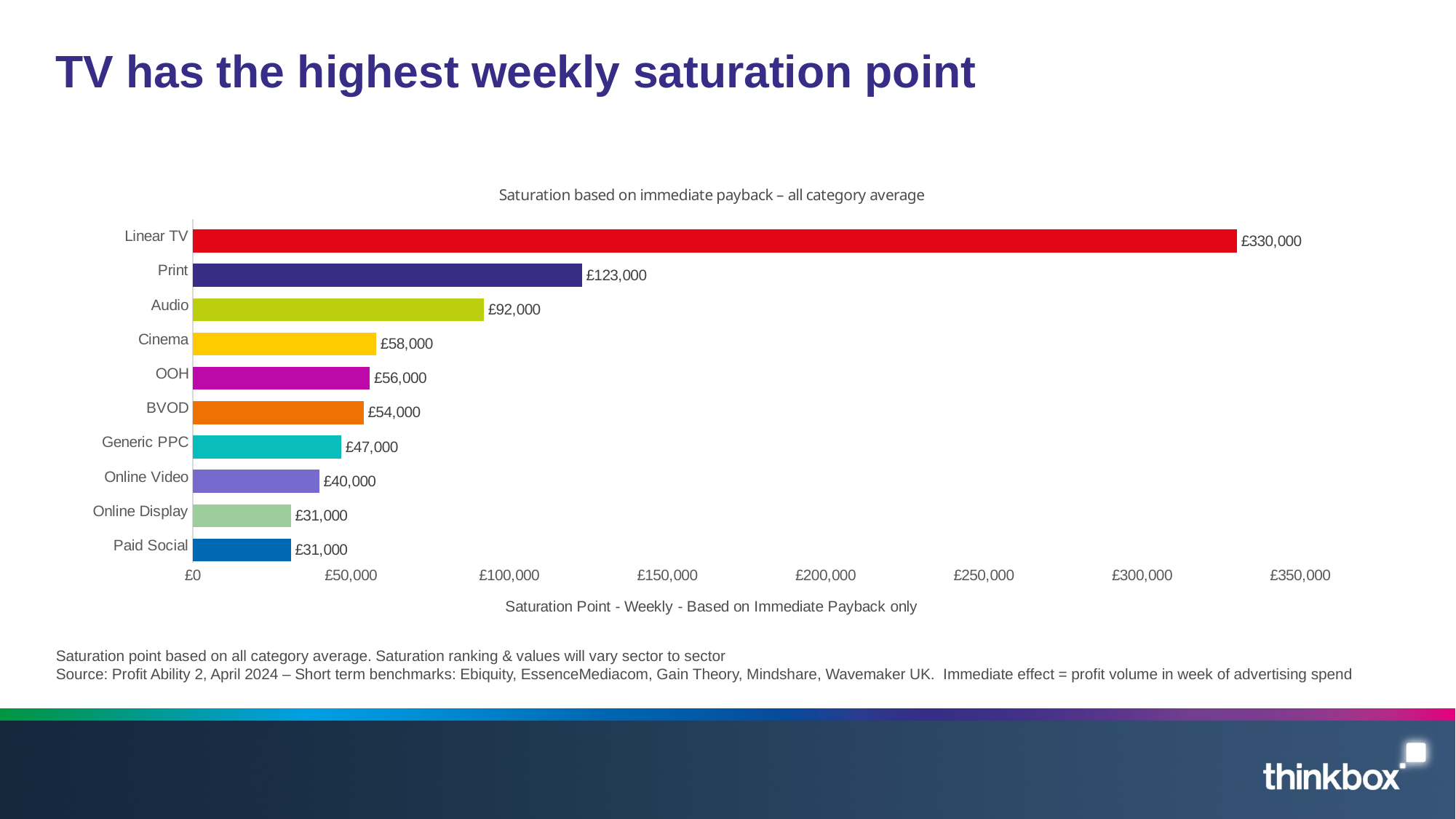
What is the saturation point for Audio? £92,000 Is the value for Print greater or less than £100,000? greater What is the saturation point for Linear TV? £330,000 What is the saturation point for Generic PPC? £47,000 Which category has the highest saturation point? Linear TV How many categories are shown in the chart? 10 Which has a larger saturation point, BVOD or Online Video? BVOD What kind of chart is shown on the slide? Bar chart What is the difference between the saturation points of Cinema and OOH? £2,000 What is the title of the chart? Saturation based on immediate payback – all category average What is the difference between the saturation points of Linear TV and Print? £207,000 Which has a larger saturation point, Print or Audio? Print